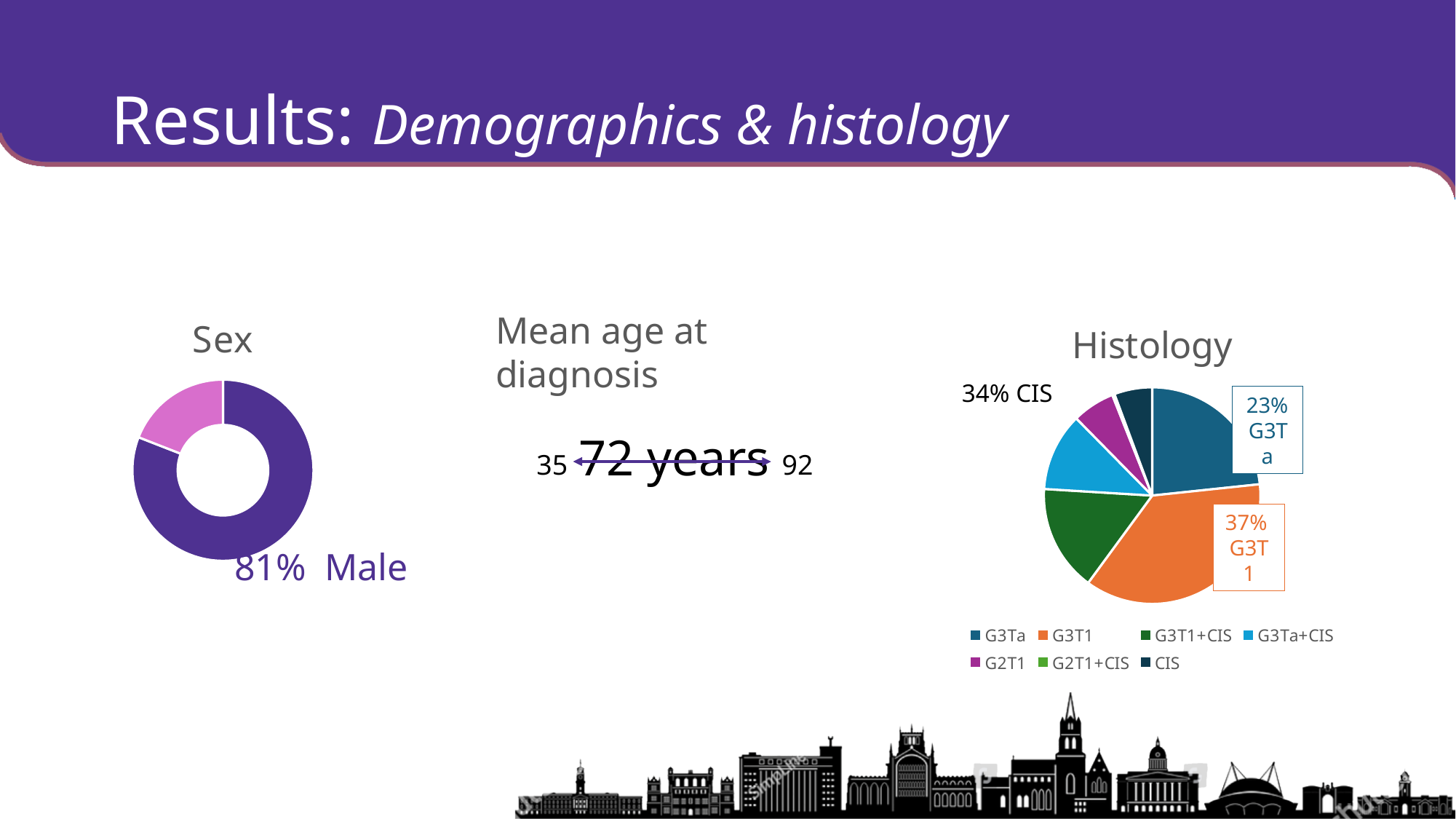
What kind of chart is the Sex chart? doughnut chart What kind of chart is the Histology chart? pie chart In the Histology chart, what percentage is labelled for G3Ta? 23% In the Histology chart, which is larger, G3T1 or G3T1+CIS? G3T1 In the Histology chart legend, what colour represents G3T1? orange In the Histology chart, what percentage is labelled for G3T1? 37% In the Histology chart, what is the difference between the G3T1 and G3Ta percentages? 14% How many entries does the legend of the Histology chart list? 7 In the Sex chart, is the Male share greater or less than 50%? greater In the Histology chart, which is larger, G3T1 or G3Ta? G3T1 In the Sex chart, what share of patients is Male? 81% In the Histology chart, which category has the largest slice? G3T1